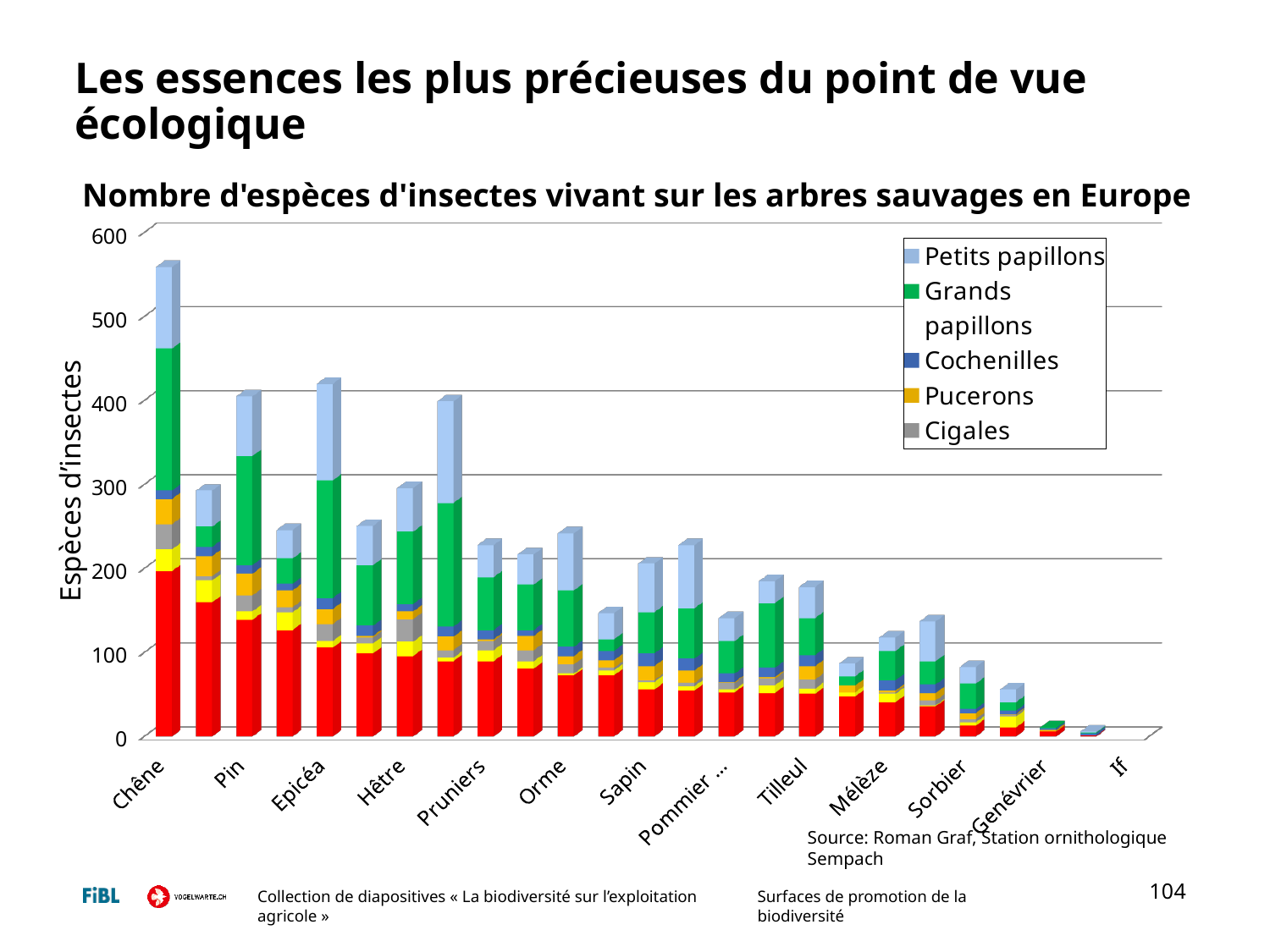
Which has a larger total, Epicéa or Hêtre? Epicéa Is the total value for Genévrier greater or less than 100? less Is the total value for Epicéa greater or less than 400? greater What kind of chart is shown on the slide? Stacked bar chart What is the label of the vertical axis? Espèces d'insectes Do the bar totals generally rise or fall from left to right along the x axis? fall Is the total value for Mélèze greater or less than 100? greater Which tree species has the highest total number of insect species? Chêne What is the title of the chart? Nombre d'espèces d'insectes vivant sur les arbres sauvages en Europe Which labelled tree species has the lowest total number of insect species? If Which has a larger total, Chêne or Pin? Chêne